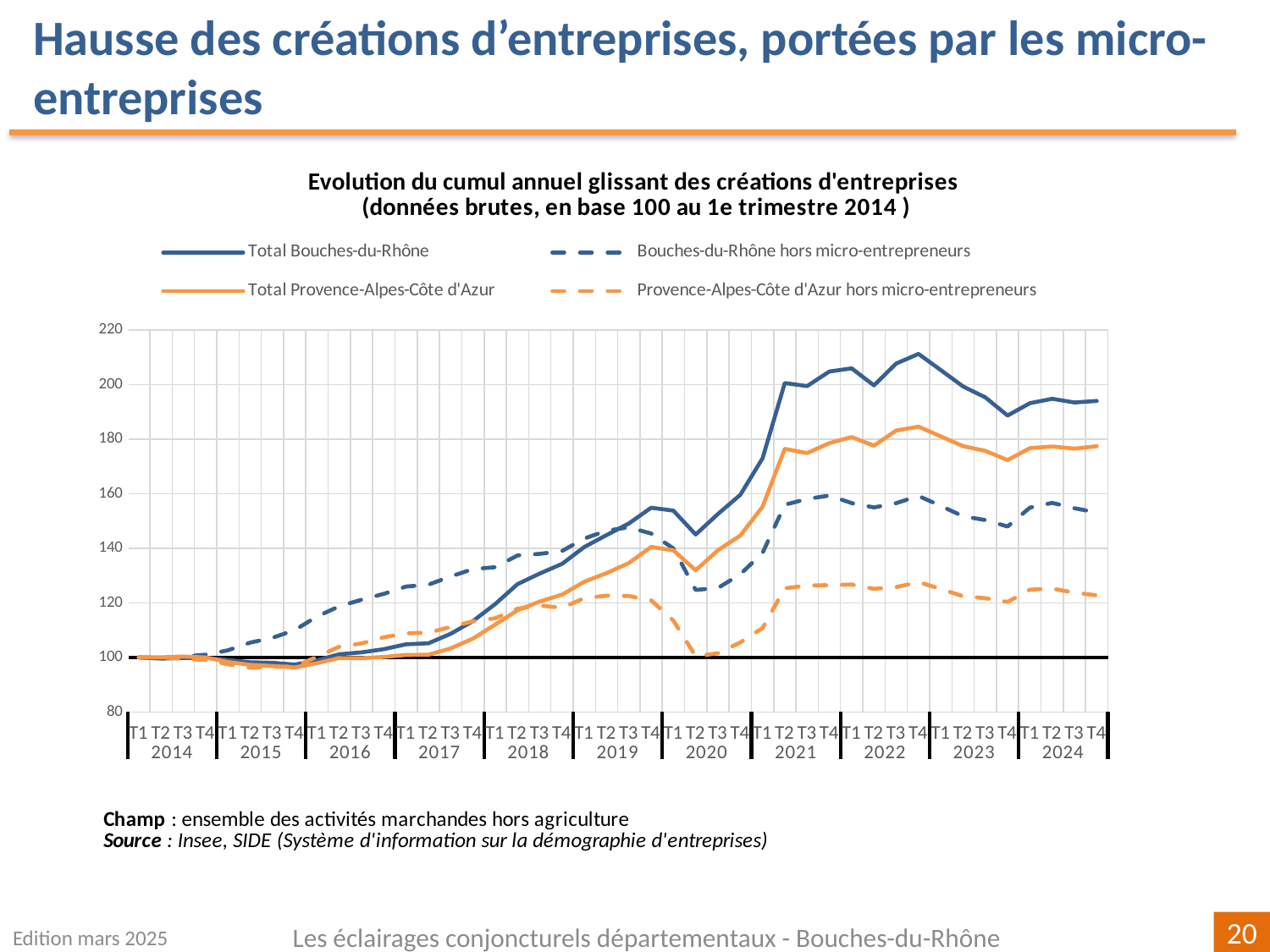
Is the value for Total Bouches-du-Rhône at T4 2024 greater or less than 180? greater At T4 2024, which is higher: Total Bouches-du-Rhône or Total Provence-Alpes-Côte d'Azur? Total Bouches-du-Rhône Is the value for Provence-Alpes-Côte d'Azur hors micro-entrepreneurs at T4 2024 greater or less than 140? less Is the value for Bouches-du-Rhône hors micro-entrepreneurs at T4 2024 greater or less than 160? less What is the title of the chart? Evolution du cumul annuel glissant des créations d'entreprises (données brutes, en base 100 au 1e trimestre 2014 ) How many series does the legend list? 4 Overall, does the Total Bouches-du-Rhône series rise or fall from T1 2014 to T4 2024? rise What kind of chart is shown on the slide? line chart How many years are shown along the x axis? 11 Which series reaches the highest value on the chart? Total Bouches-du-Rhône